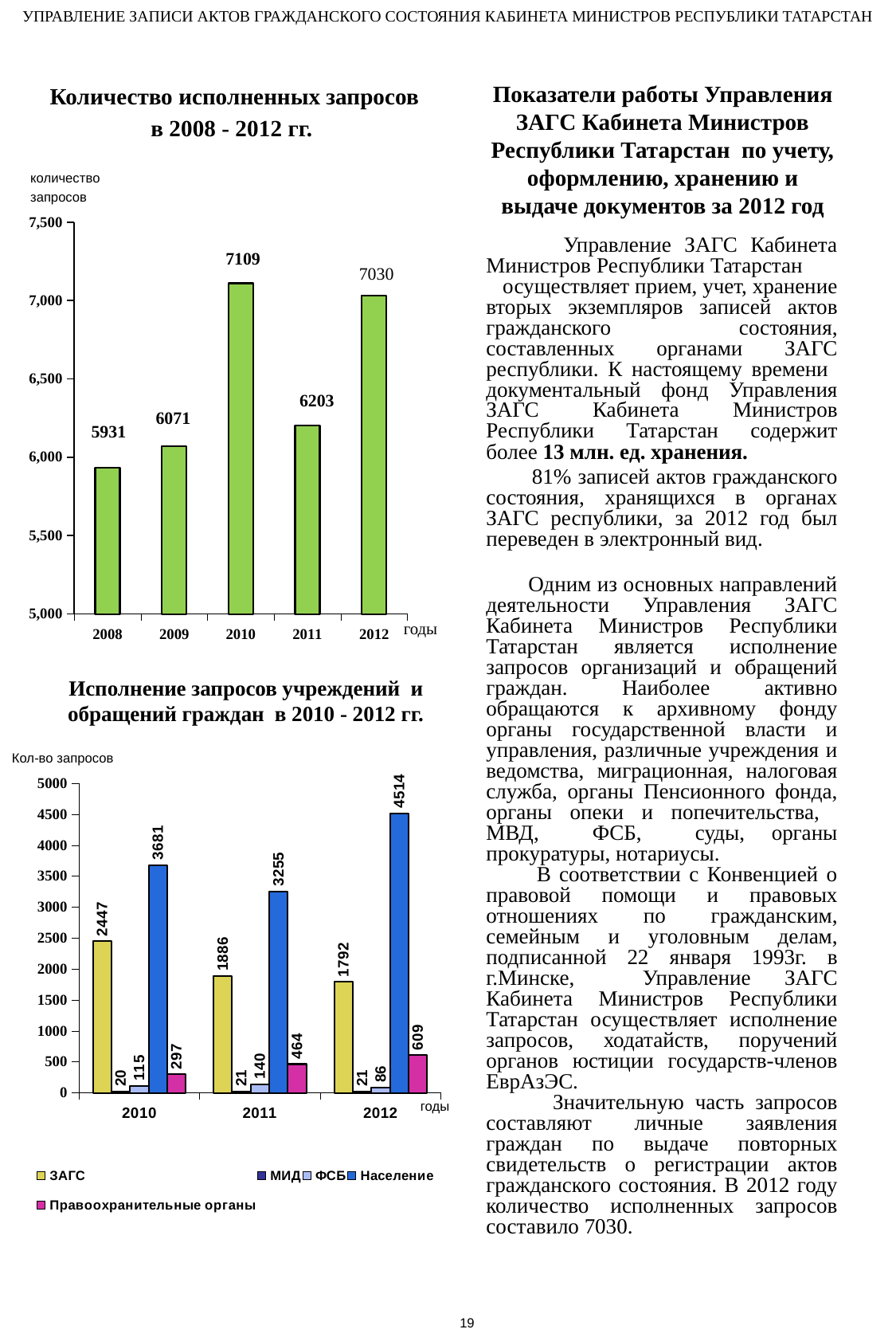
In the chart 'Количество исполненных запросов в 2008 - 2012 гг.', which year has the lowest value? 2008 In the chart 'Исполнение запросов учреждений и обращений граждан в 2010 - 2012 гг.', does the value for ЗАГС rise or fall from 2010 to 2012? fall In the chart 'Исполнение запросов учреждений и обращений граждан в 2010 - 2012 гг.', what is the value for Население in 2012? 4514 In the chart 'Исполнение запросов учреждений и обращений граждан в 2010 - 2012 гг.', what is the value for Правоохранительные органы in 2011? 464 In the chart 'Исполнение запросов учреждений и обращений граждан в 2010 - 2012 гг.', what is the difference between ФСБ in 2011 and ФСБ in 2012? 54 In the chart 'Количество исполненных запросов в 2008 - 2012 гг.', how many years are shown on the x axis? 5 In the chart 'Исполнение запросов учреждений и обращений граждан в 2010 - 2012 гг.', how many series does the legend list? 5 In the chart 'Количество исполненных запросов в 2008 - 2012 гг.', is the value for 2012 greater or less than 7,000? greater What kind of chart is 'Исполнение запросов учреждений и обращений граждан в 2010 - 2012 гг.'? bar chart In the chart 'Количество исполненных запросов в 2008 - 2012 гг.', what is the value for 2010? 7109 In the chart 'Количество исполненных запросов в 2008 - 2012 гг.', what is the difference between the values for 2010 and 2011? 906 In the chart 'Исполнение запросов учреждений и обращений граждан в 2010 - 2012 гг.', which is larger: ЗАГС in 2010 or ЗАГС in 2012? ЗАГС in 2010